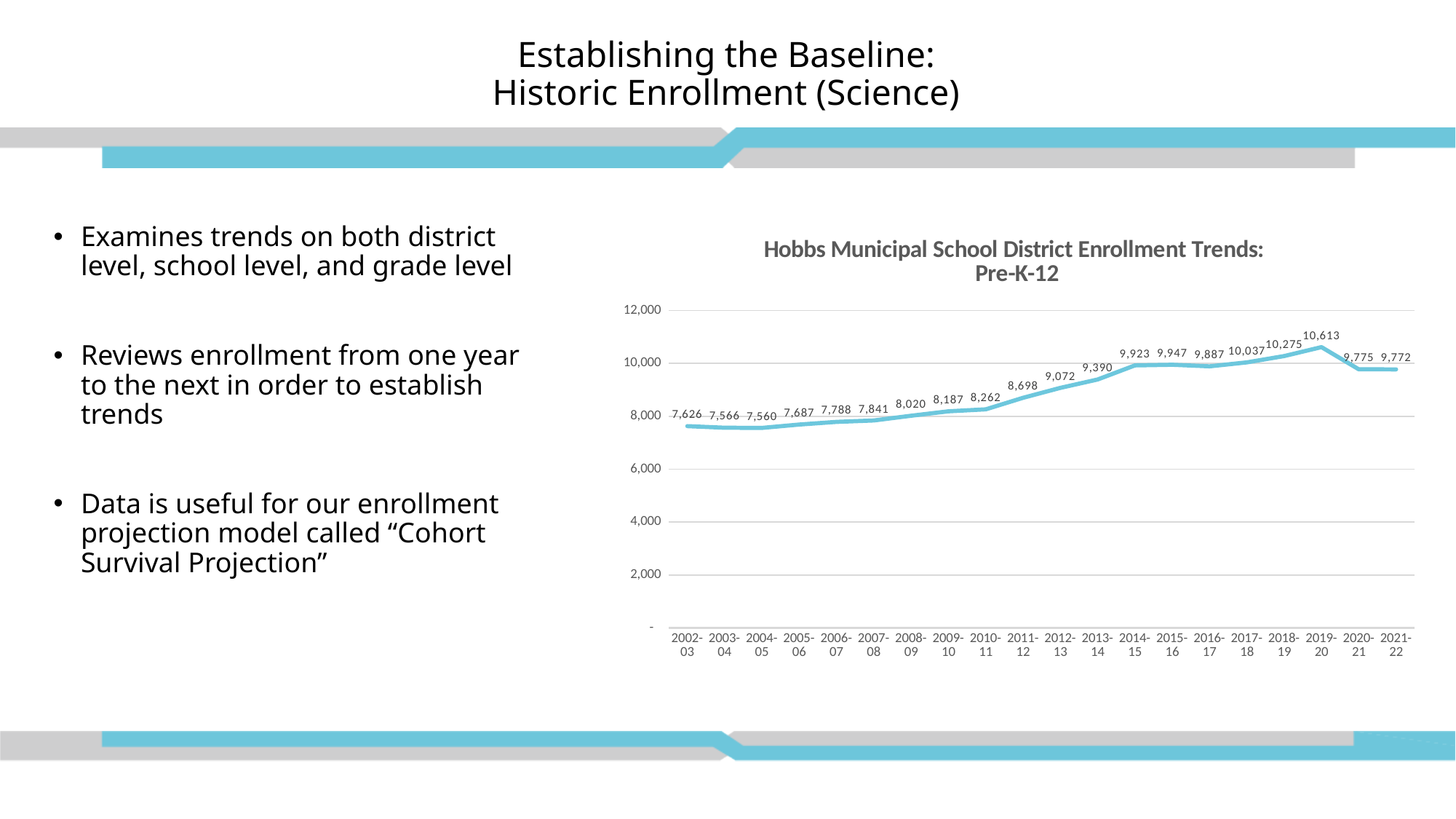
What is the title of the chart? Hobbs Municipal School District Enrollment Trends: Pre-K-12 What is the enrollment value for 2012-13? 9,072 What kind of chart is shown on the slide? line chart What is the enrollment value for 2019-20? 10,613 What is the enrollment value for 2002-03? 7,626 What is the enrollment value for 2021-22? 9,772 How many school years are plotted on the chart? 20 Which school year has the highest enrollment? 2019-20 Which is larger, the enrollment for 2014-15 or for 2016-17? 2014-15 Is the enrollment value for 2017-18 greater or less than 10,000? greater What is the difference in enrollment between 2019-20 and 2020-21? 838 Which school year has the lowest enrollment? 2004-05